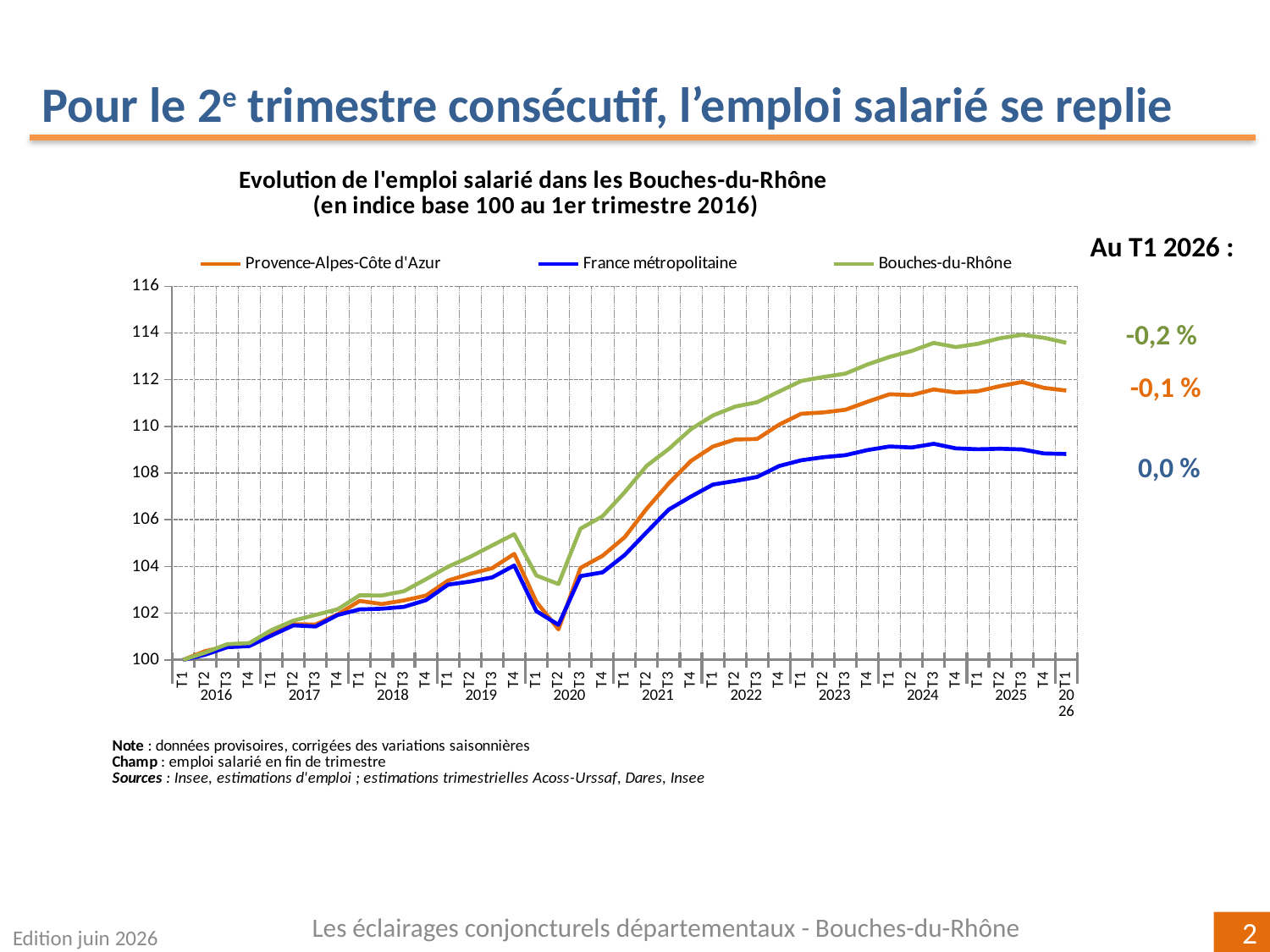
Overall, do the series rise or fall between T1 2016 and T1 2026? rise Which series has the lowest value at T1 2026? France métropolitaine What quarterly change is annotated for Bouches-du-Rhône at T1 2026? -0,2 % Which series has the highest value at T1 2026? Bouches-du-Rhône What is the index value of all three series at T1 2016? 100 How many series does the legend list? 3 Is the value for Bouches-du-Rhône at T2 2020 greater or less than 104? less Is the value for France métropolitaine at T1 2026 greater or less than 110? less Is the value for Bouches-du-Rhône at T1 2026 greater or less than 112? greater At T1 2024, which is larger: Bouches-du-Rhône or France métropolitaine? Bouches-du-Rhône Which series is drawn in green in the chart? Bouches-du-Rhône What kind of chart is shown on the slide? line chart